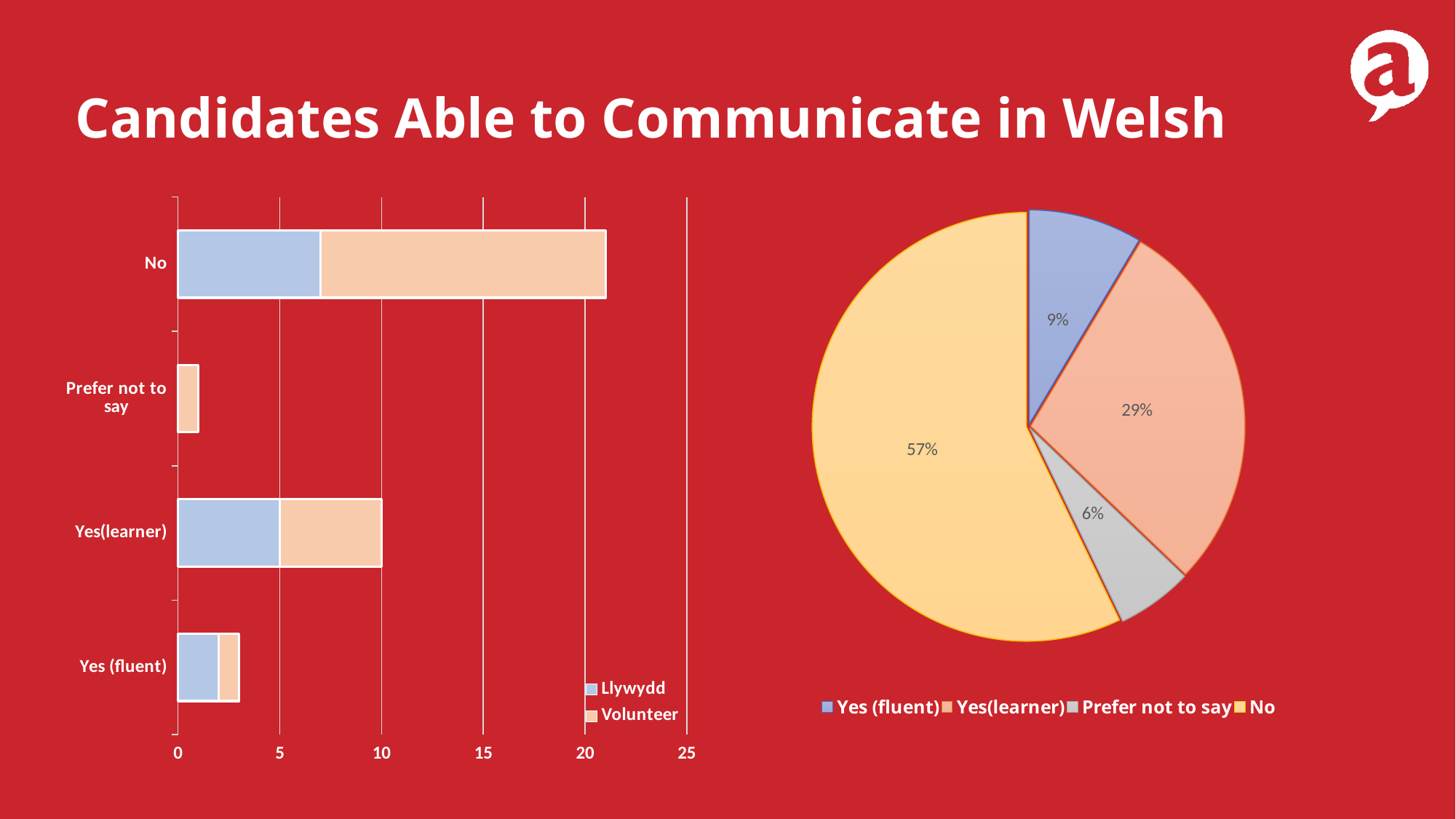
In the bar chart, is the total value for No greater or less than 20? greater In the pie chart, what share is labelled for the Yes (fluent) slice? 9% How many categories are shown on the bar chart? 4 In the pie chart, which category has the largest slice? No What kind of chart is the chart on the left of the slide? bar chart In the pie chart, what share is labelled for the Yes(learner) slice? 29% What kind of chart is the chart on the right of the slide? pie chart How many series does the legend of the bar chart list? 2 In the pie chart, what share is labelled for the No slice? 57% In the pie chart, what is the difference between the Yes(learner) share and the Yes (fluent) share? 20% In the pie chart, which category has the smallest slice? Prefer not to say In the bar chart, which category has the longest bar? No